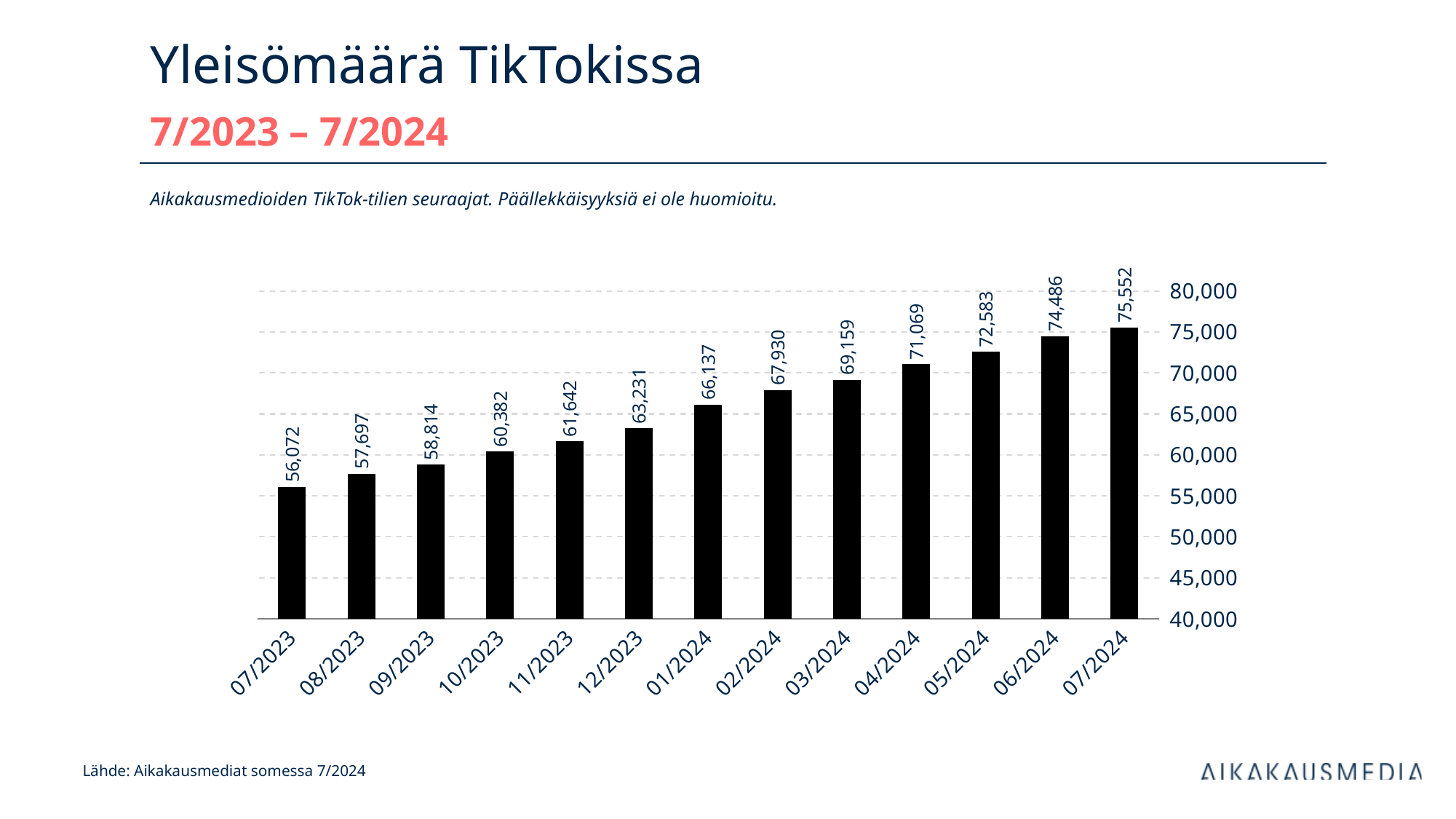
How many months are shown on the x axis? 13 Is the value for 04/2024 greater or less than 70,000? greater Which is larger, the value for 12/2023 or the value for 03/2024? 03/2024 What kind of chart is shown on the slide? bar chart Do the values rise or fall from 07/2023 to 07/2024? rise Which month has the highest value? 07/2024 What is the value for 07/2024? 75,552 What is the value for 07/2023? 56,072 What is the difference between the values for 07/2024 and 07/2023? 19,480 What is the value for 01/2024? 66,137 Which month has the lowest value? 07/2023 What is the difference between the values for 06/2024 and 05/2024? 1,903